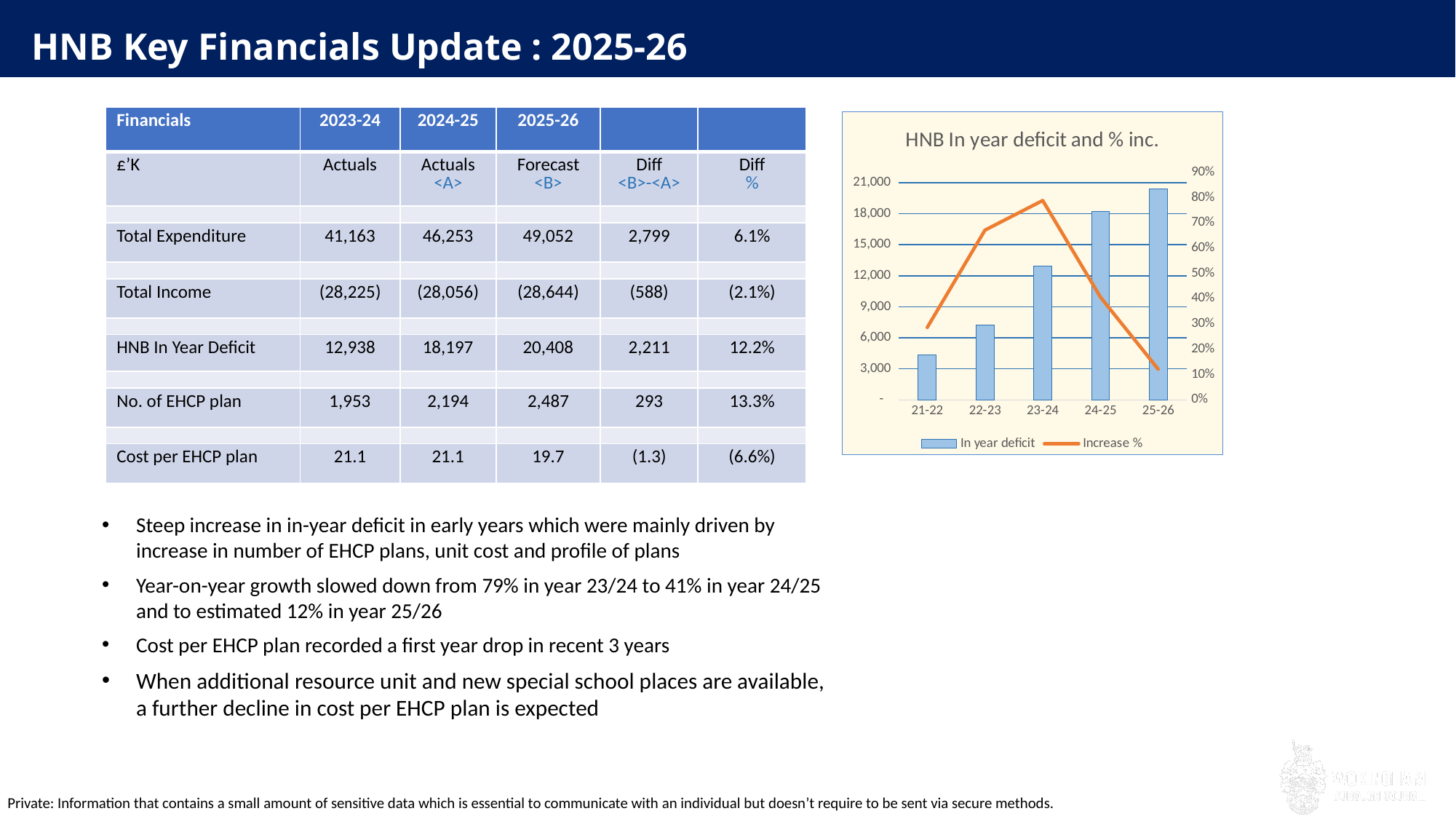
How many series does the chart's legend list? 2 Which year has the highest In year deficit bar? 25-26 Is the In year deficit for 21-22 greater or less than 6,000? less Which year has the lowest In year deficit bar? 21-22 Do the In year deficit bars rise or fall from 21-22 to 25-26? Rise In which year does the Increase % line reach its peak? 23-24 Is the Increase % for 23-24 greater or less than 70%? greater How many years are shown on the x axis of the chart? 5 What kind of chart is shown on the slide? Combined bar and line chart In which year is the Increase % line at its lowest? 25-26 Is the In year deficit for 24-25 larger than the In year deficit for 23-24? Yes What is the title of the chart on the slide? HNB In year deficit and % inc.